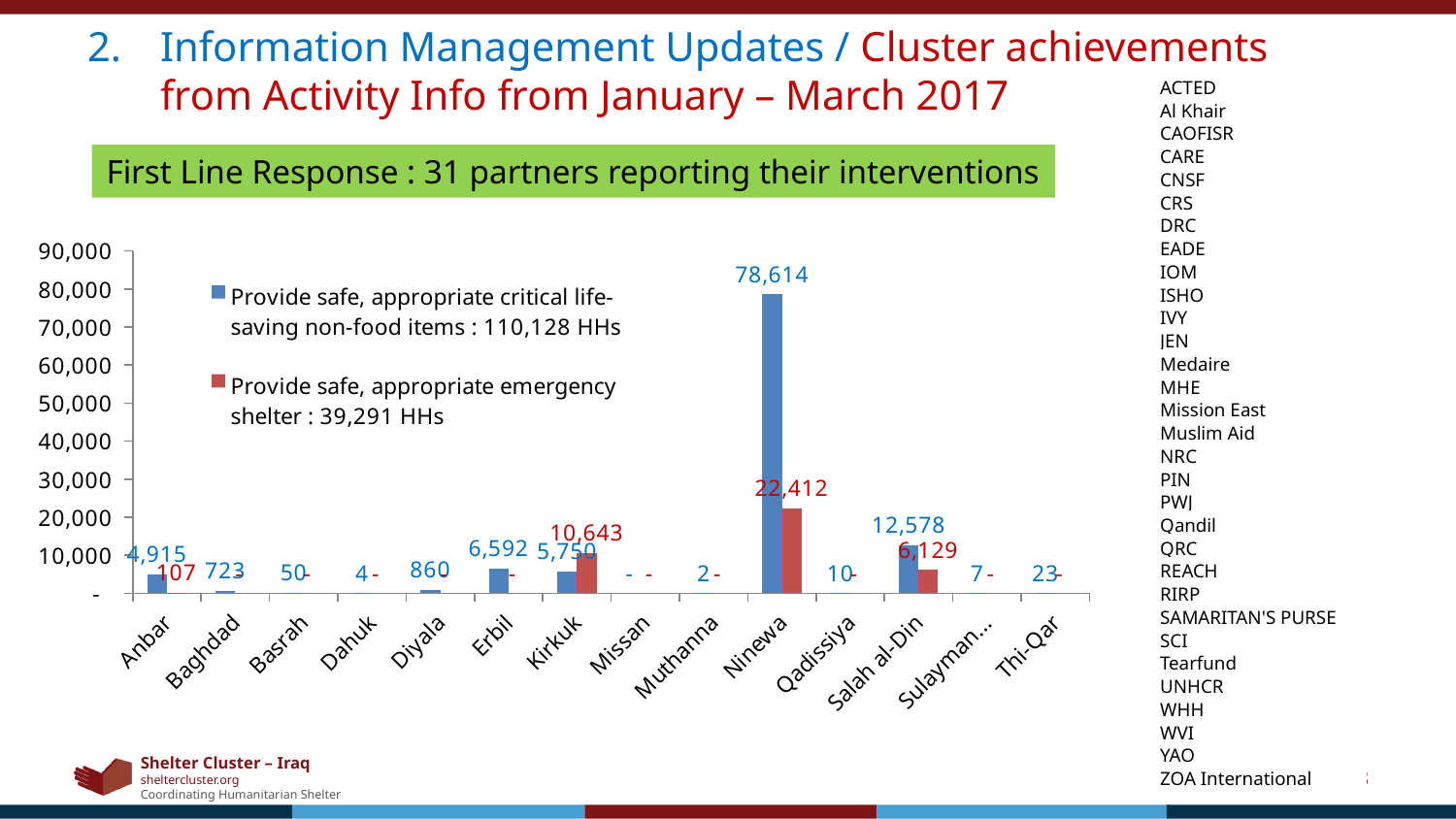
How many series does the chart legend list? 2 What kind of chart is shown on the slide? Bar chart What is the value for Ninewa in the 'Provide safe, appropriate emergency shelter' series? 22,412 What is the value for Salah al-Din in the 'Provide safe, appropriate critical life-saving non-food items' series? 12,578 Which governorate has the highest value in the 'Provide safe, appropriate critical life-saving non-food items' series? Ninewa For Kirkuk, which series has the larger value: critical life-saving non-food items or emergency shelter? Emergency shelter What is the difference between the two series' values for Salah al-Din? 6,449 What is the difference between the two series' values for Ninewa? 56,202 What is the value for Erbil in the 'Provide safe, appropriate critical life-saving non-food items' series? 6,592 How many governorates are shown on the x axis of the chart? 14 What is the value for Kirkuk in the 'Provide safe, appropriate emergency shelter' series? 10,643 What is the value for Ninewa in the 'Provide safe, appropriate critical life-saving non-food items' series? 78,614